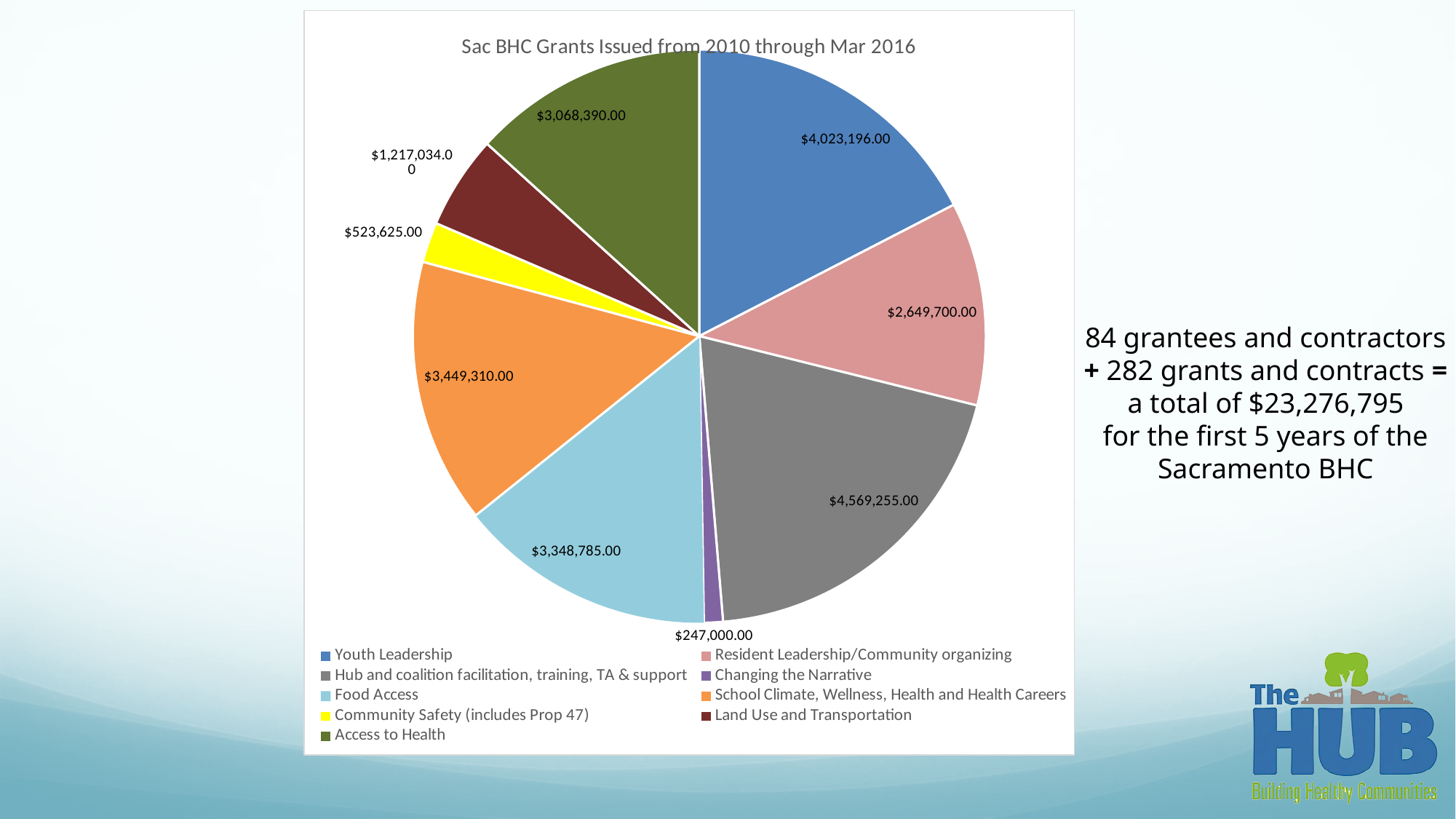
What is the difference between the values for Hub and coalition facilitation, training, TA & support and Youth Leadership? $546,059.00 What is the value for Land Use and Transportation? $1,217,034.00 What is the value for Changing the Narrative? $247,000.00 How many categories does the pie chart show? 9 What is the value for Food Access? $3,348,785.00 What is the title of the chart? Sac BHC Grants Issued from 2010 through Mar 2016 Which category has the smallest slice? Changing the Narrative What colour is the slice for Community Safety (includes Prop 47)? Yellow What kind of chart is shown on the slide? Pie chart What is the value for Youth Leadership? $4,023,196.00 Which is larger, the value for Access to Health or the value for Resident Leadership/Community organizing? Access to Health Which category has the largest slice? Hub and coalition facilitation, training, TA & support